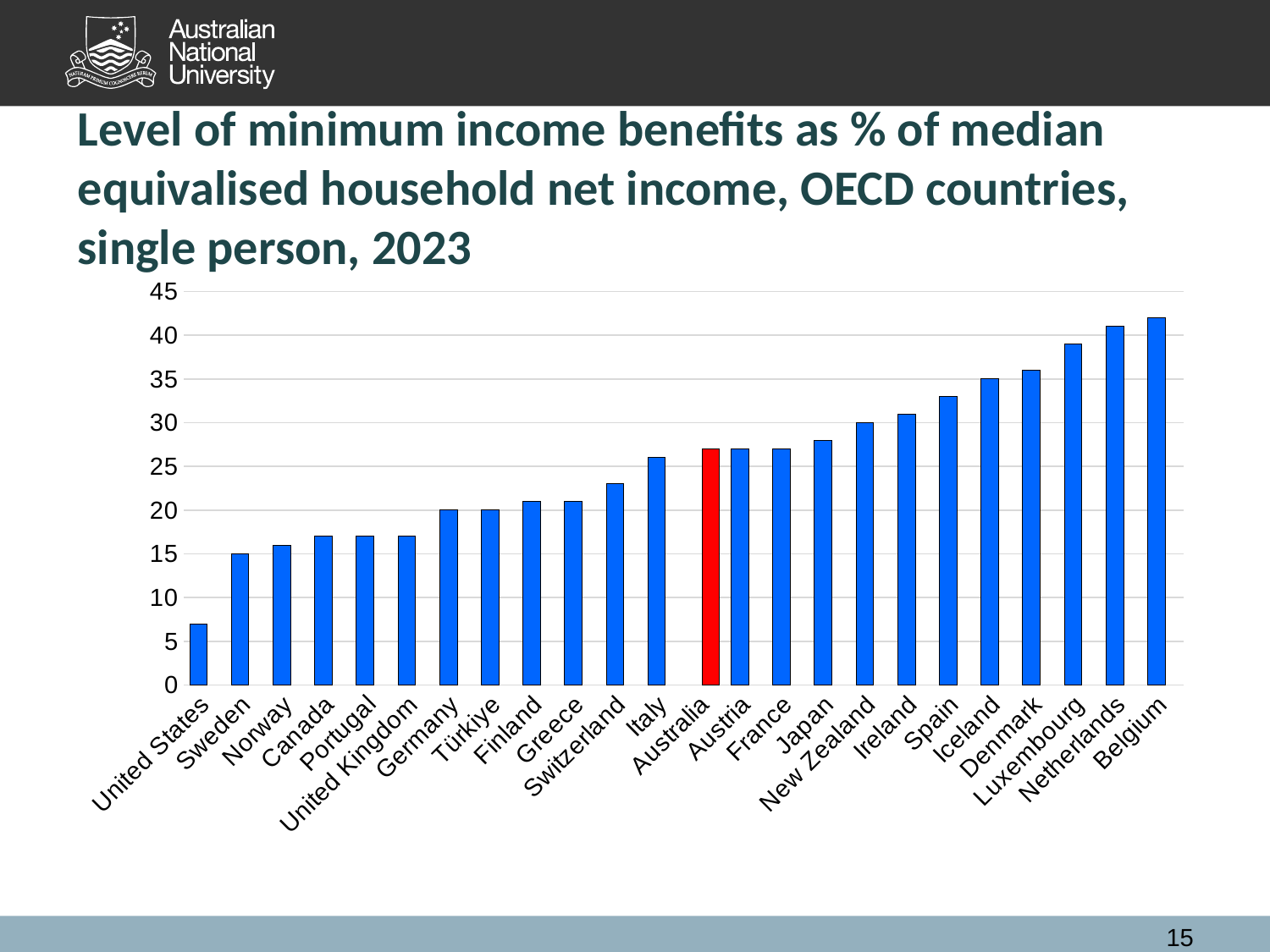
Is the value for Canada greater or less than 20? less Which country has the lowest level of minimum income benefits in the chart? United States Which country's bar is coloured red in the chart? Australia Which has a larger value, Spain or Norway? Spain How many countries are shown in the chart? 24 Is the value for the United States greater or less than 10? less Do the values rise or fall moving from left to right along the x axis? rise Is the value for Belgium greater or less than 40? greater Which has a larger value, Sweden or Luxembourg? Luxembourg What kind of chart is shown on the slide? bar chart Which country has the highest level of minimum income benefits in the chart? Belgium